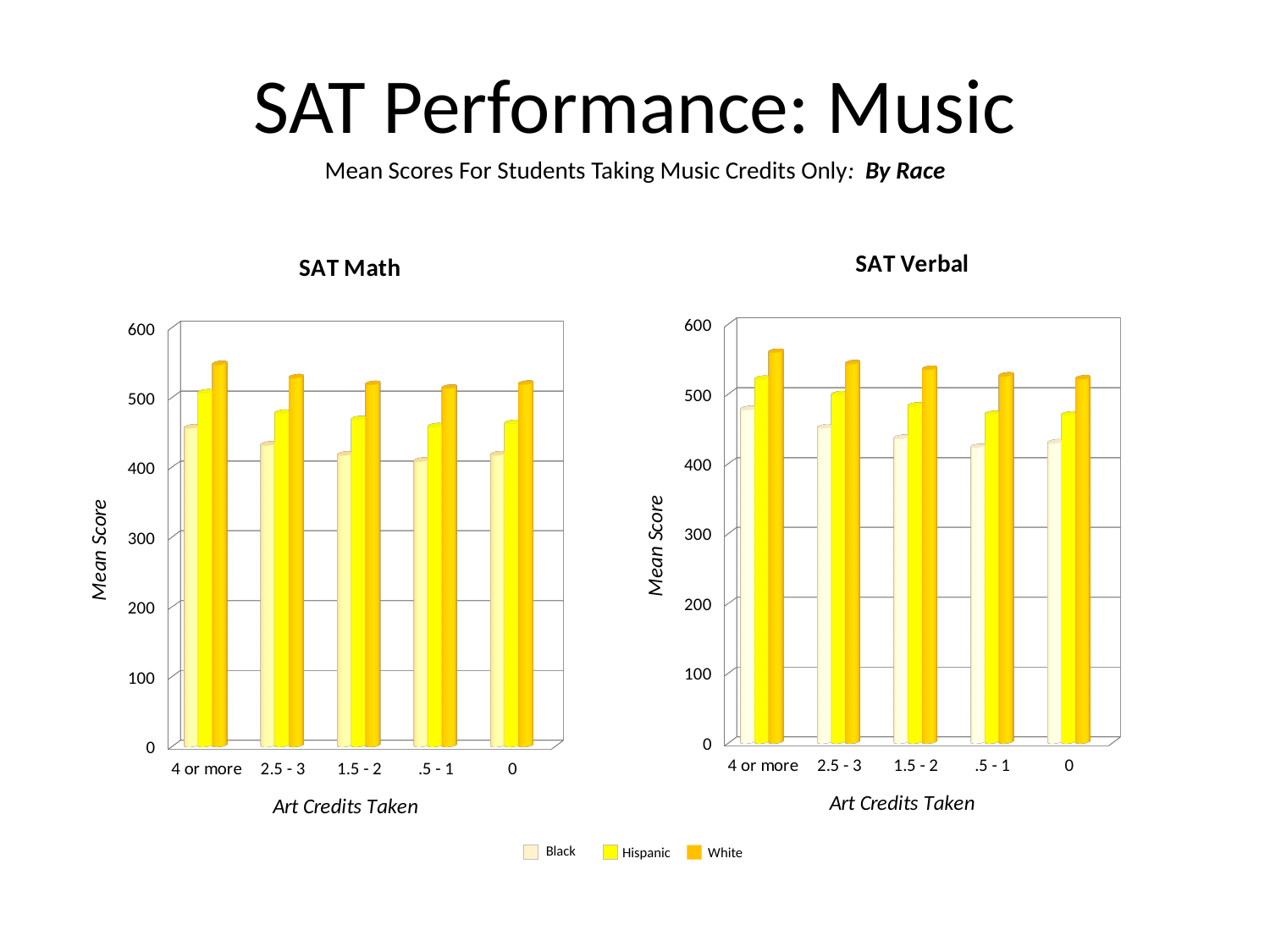
In the SAT Math chart, which is larger: the Hispanic bar for 4 or more art credits or the Hispanic bar for 0 art credits? 4 or more How many Art Credits Taken categories are shown on the x axis of the SAT Verbal chart? 5 In the SAT Verbal chart, for the 4 or more category, which is larger: the White bar or the Black bar? White How many series does the legend list for the charts? 3 In the SAT Math chart, is the value for White students with 4 or more art credits greater or less than 500? greater In the SAT Verbal chart, is the value for Hispanic students with 4 or more art credits greater or less than 500? greater What is the y-axis title on the SAT Verbal chart? Mean Score What is the x-axis title on the SAT Math chart? Art Credits Taken What kind of chart is the SAT Math chart? bar chart In the SAT Math chart, is the value for Black students with .5 - 1 art credits greater or less than 500? less In the SAT Math chart, which Art Credits Taken category has the highest White bar? 4 or more